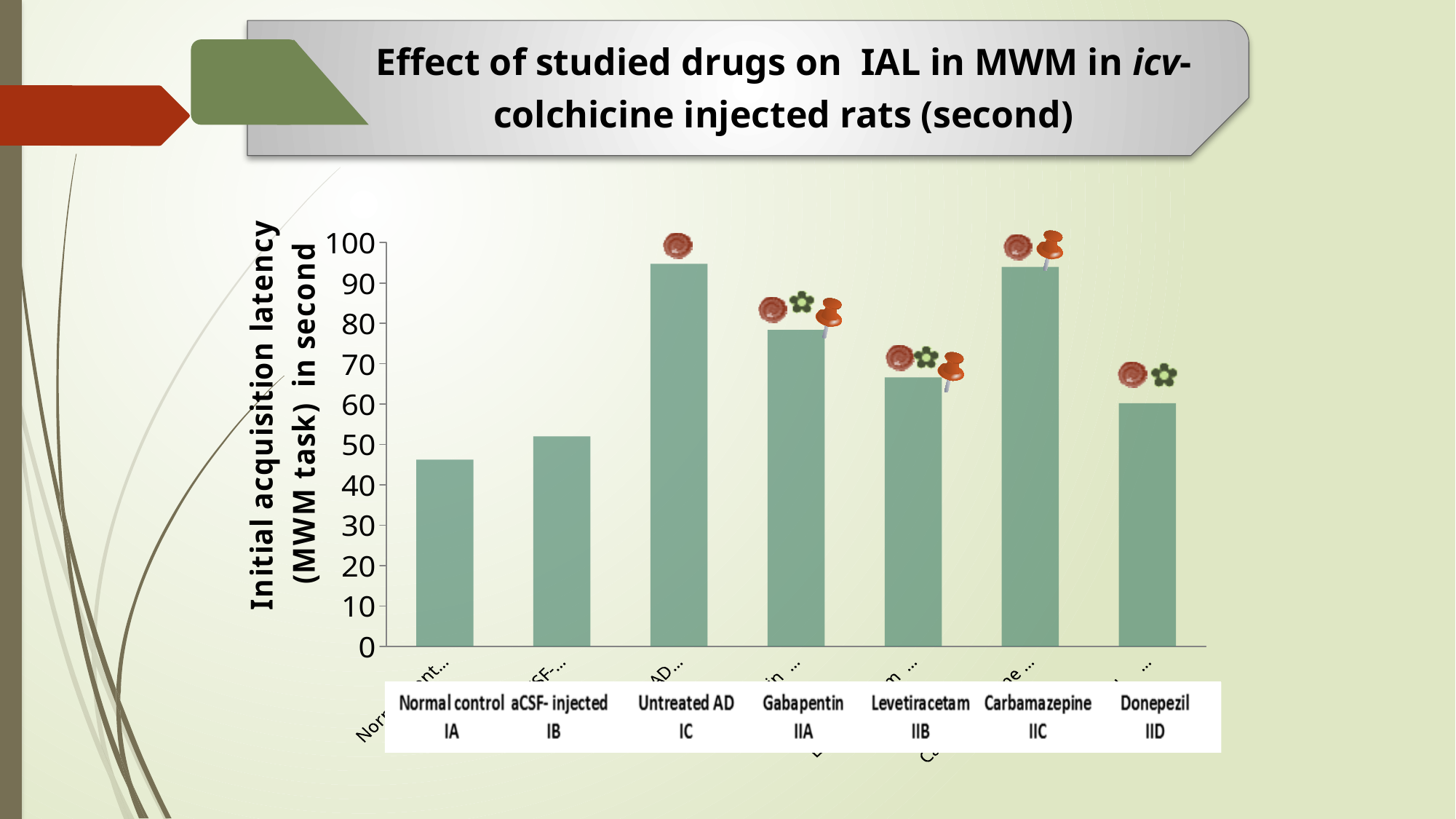
Which group has the lowest initial acquisition latency? Normal control IA Is the value for Untreated AD IC greater or less than 90? greater Is the value for Carbamazepine IIC greater or less than 90? greater Which has the higher initial acquisition latency, Gabapentin IIA or Levetiracetam IIB? Gabapentin IIA Is the value for Levetiracetam IIB greater or less than 70? less What is the title of the vertical axis? Initial acquisition latency (MWM task) in second What kind of chart is shown on the slide? bar chart How many groups (bars) are plotted in the chart? 7